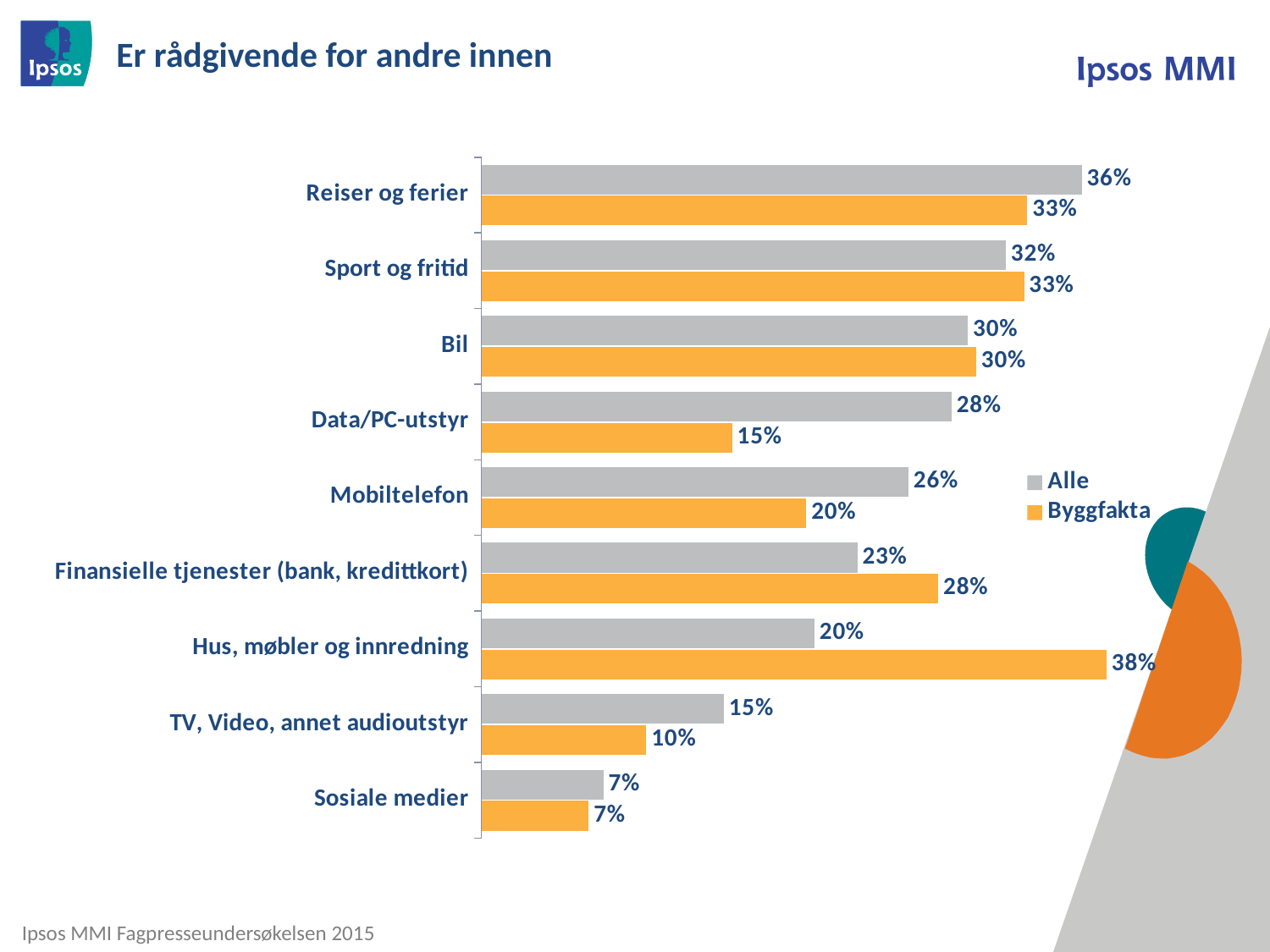
How many categories are shown in the chart? 9 Which category has the lowest value for the Alle series? Sosiale medier What is the value for Byggfakta in the Data/PC-utstyr category? 15% What kind of chart is shown on the slide? Bar chart What is the value for Byggfakta in the Hus, møbler og innredning category? 38% Which is larger for Mobiltelefon: the Alle value or the Byggfakta value? Alle What is the value for Alle in the Reiser og ferier category? 36% Which is larger for Finansielle tjenester (bank, kredittkort): the Alle value or the Byggfakta value? Byggfakta Which category has the highest value for the Byggfakta series? Hus, møbler og innredning What is the difference between the Alle and Byggfakta values for Hus, møbler og innredning? 18% How many series does the legend list? 2 What is the difference between the Alle and Byggfakta values for Data/PC-utstyr? 13%